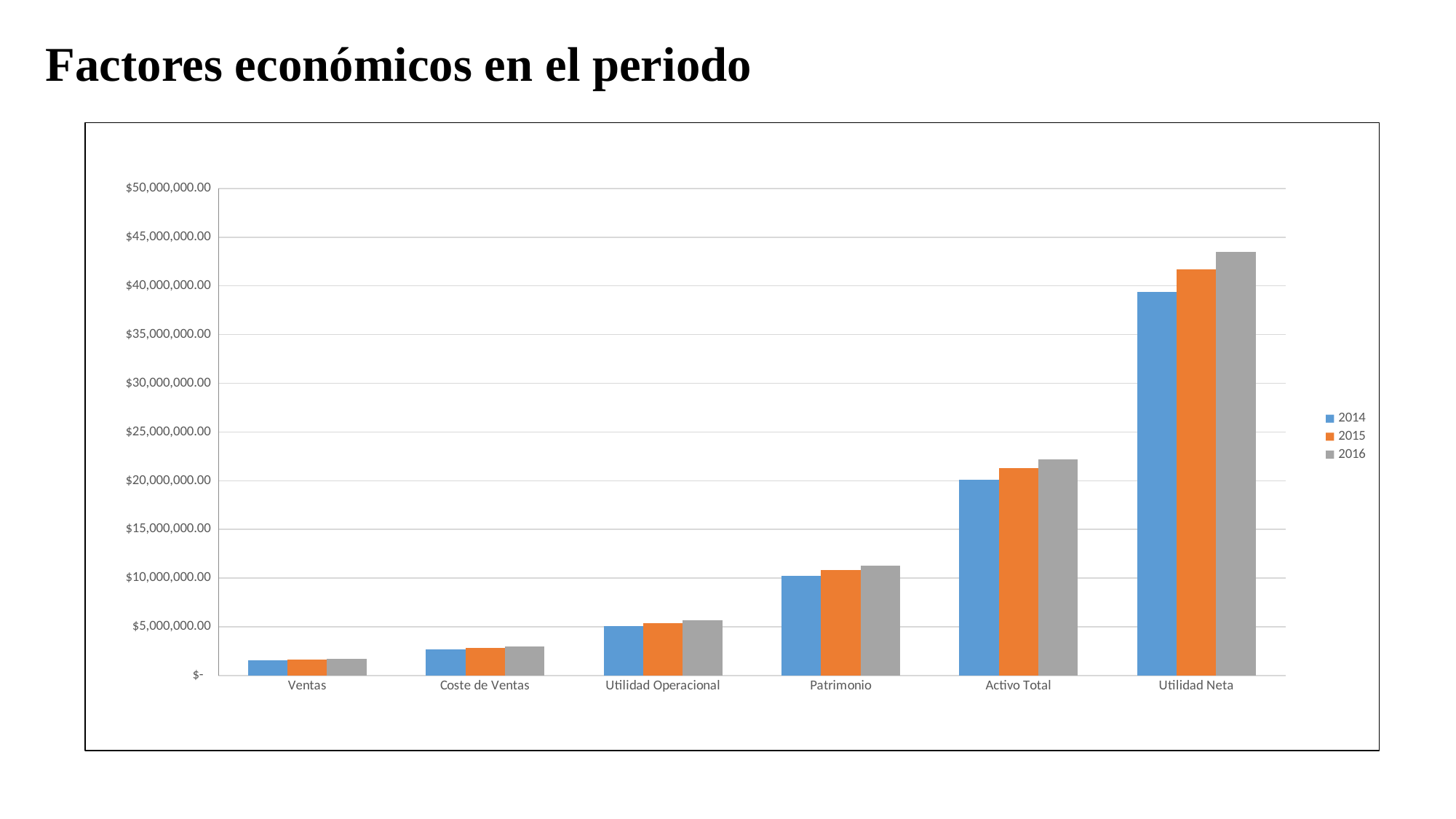
Which category has the lowest value for the 2014 series? Ventas Within the Utilidad Neta category, which year has the larger value: 2014 or 2016? 2016 Is the 2016 value for Coste de Ventas greater or less than $5,000,000.00? less Is the 2014 value for Utilidad Neta greater or less than $35,000,000.00? greater Do the values rise or fall moving from Ventas to Utilidad Neta along the x axis? Rise What kind of chart is shown on the slide? Bar chart How many categories are shown on the x axis of the chart? 6 Which category has the highest value for the 2016 series? Utilidad Neta How many series does the legend list? 3 Is the 2016 value for Utilidad Neta greater or less than $45,000,000.00? less Which is larger for 2015: Activo Total or Patrimonio? Activo Total